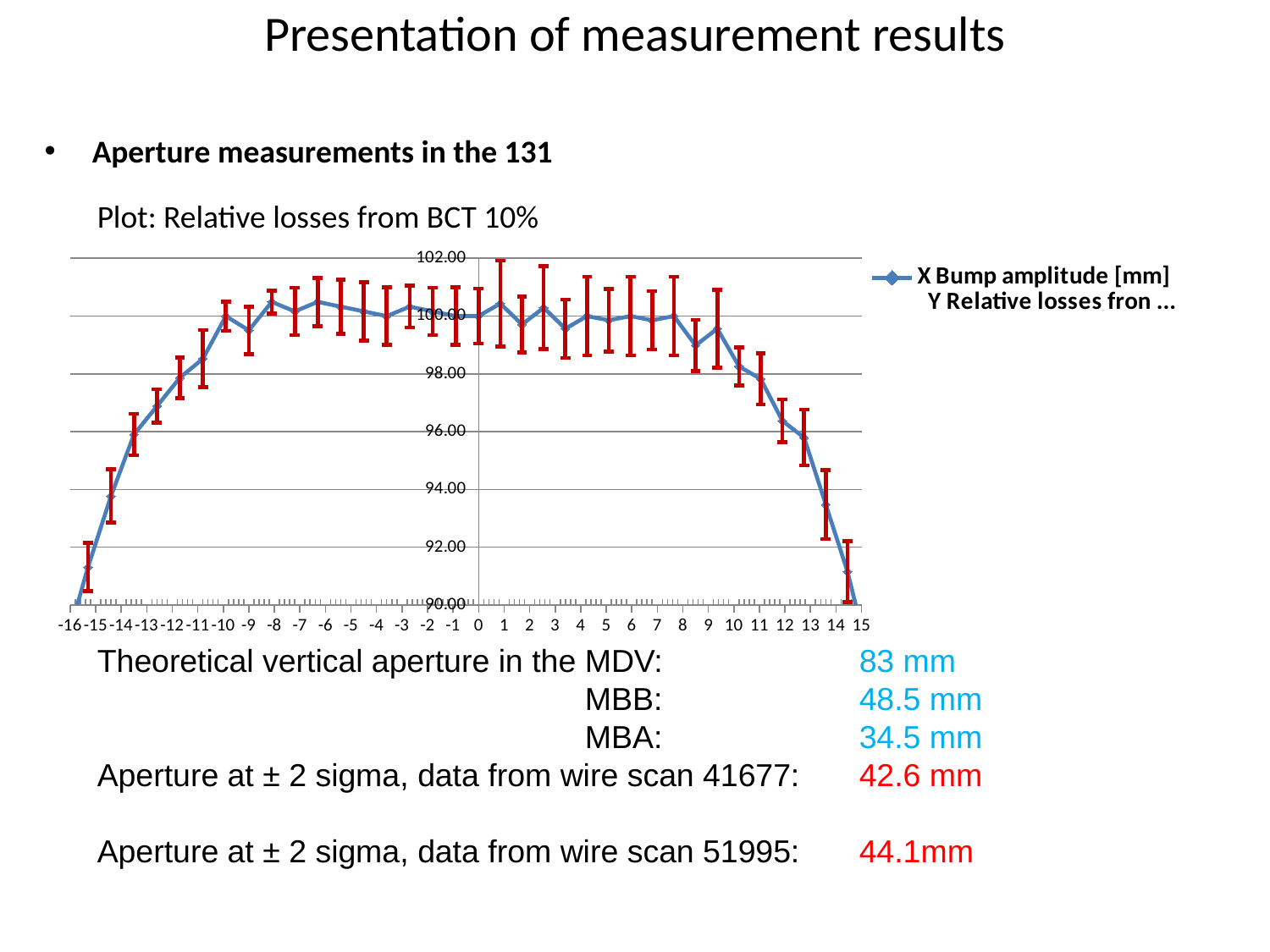
Is the value at x = 13 greater or less than 98.00? less Is the value at x = 0 greater or less than 98.00? greater What is the highest value shown on the chart's y axis? 102.00 How many x-axis categories are labelled on the chart, from -16 to 15? 32 Is the value at x = 15 greater or less than 92.00? less Do the values rise or fall along the x axis from x = 8 to x = 15? fall What kind of chart is shown on the slide? line chart Which is larger, the value at x = -16 or the value at x = 0? x = 0 Do the values rise or fall along the x axis from x = -16 to x = -8? rise How many series does the chart legend list? 1